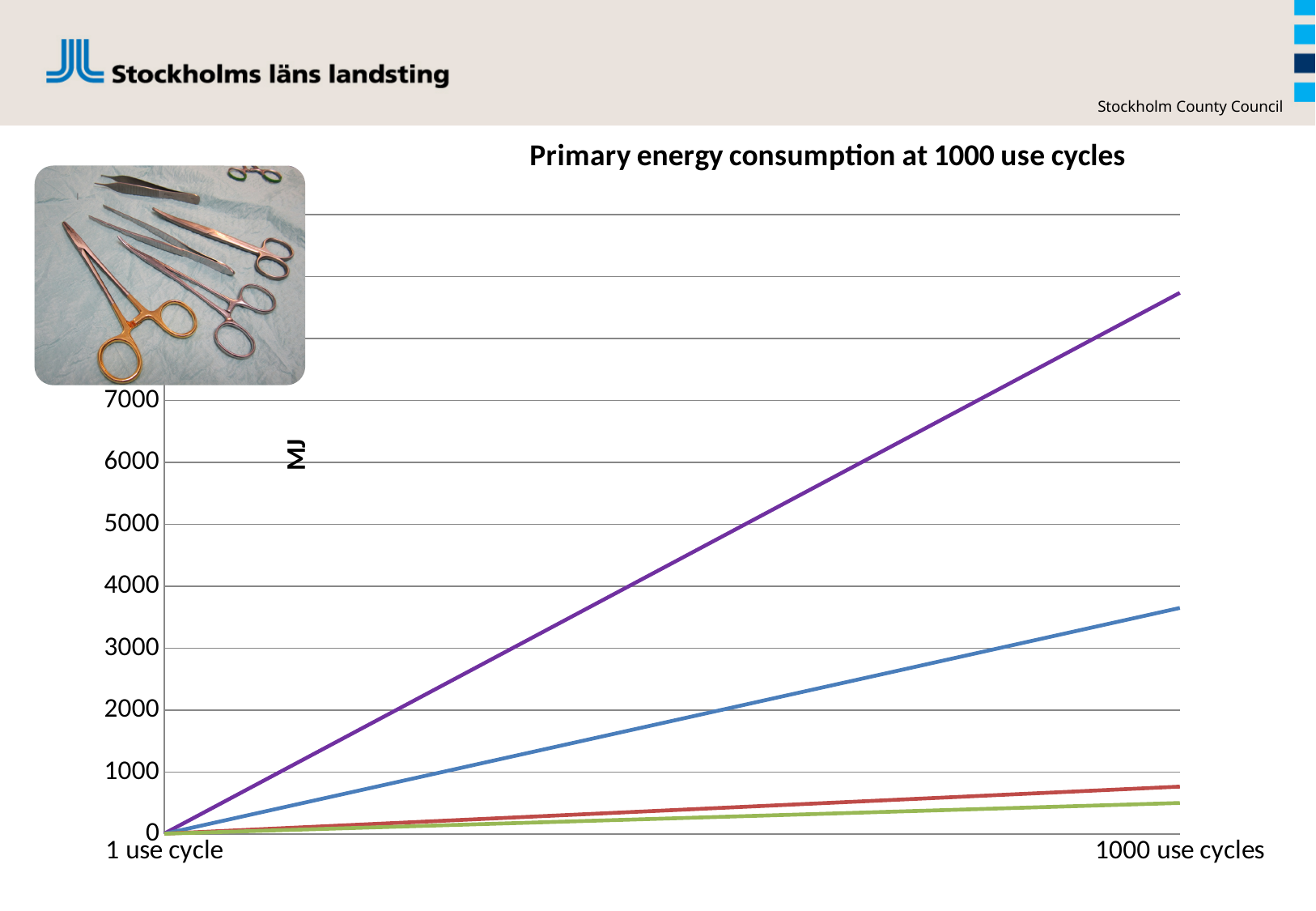
How many lines are plotted on the chart? 4 What unit is shown on the y axis of the chart? MJ At 1000 use cycles, which is larger, the value of the purple line or the value of the blue line? the purple line Is the value of the blue line at 1000 use cycles greater or less than 4000? less Is the value of the red line at 1000 use cycles greater or less than 1000? less Which line has the lowest value at 1000 use cycles? the green line What is the title of the chart? Primary energy consumption at 1000 use cycles What kind of chart is shown on the slide? line chart Is the value of the purple line at 1000 use cycles greater or less than 7000? greater Do the lines rise or fall from 1 use cycle to 1000 use cycles? rise How many points are labelled on the x axis of the chart? 2 Which line reaches the highest value at 1000 use cycles? the purple line